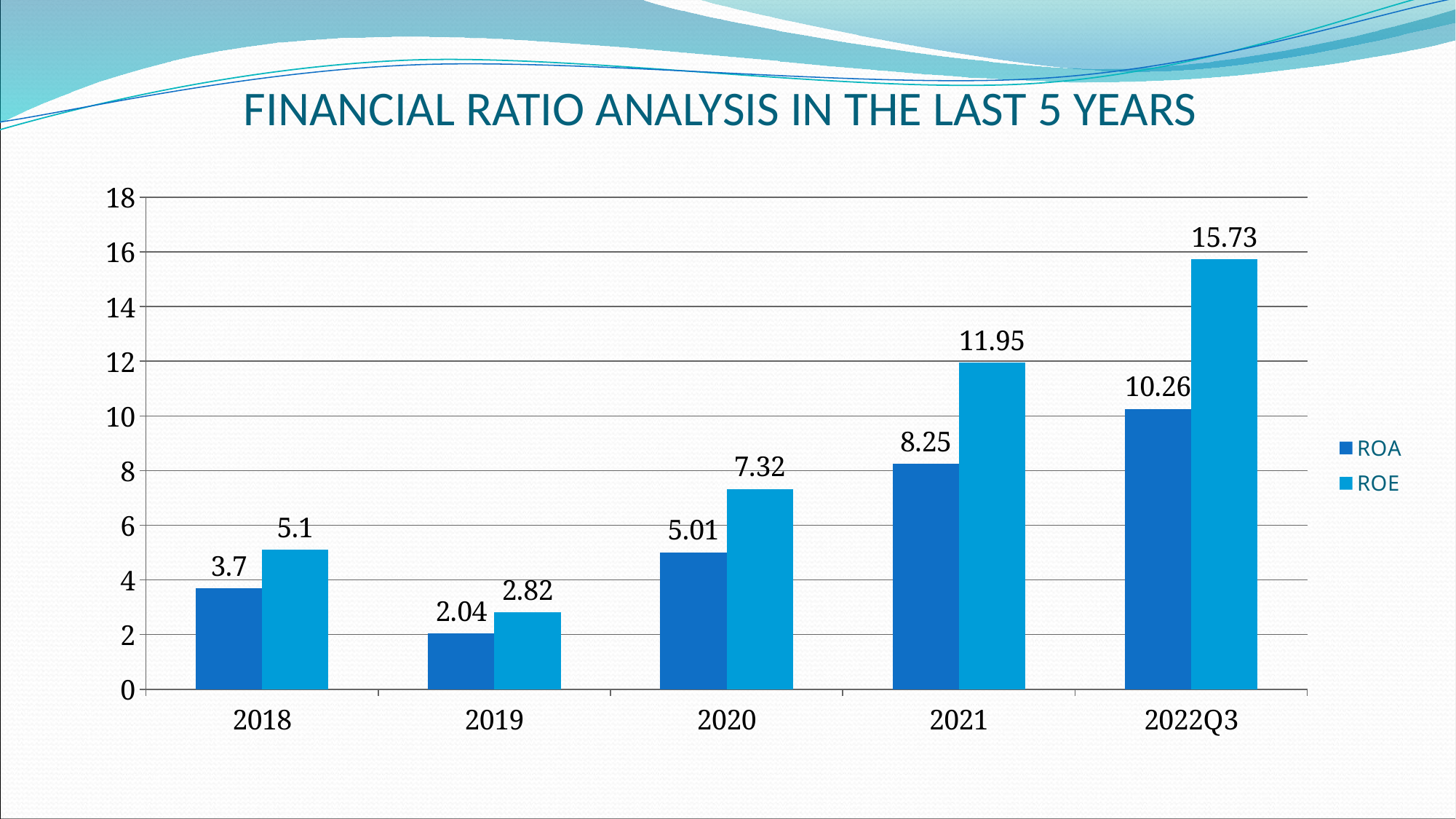
Which year has the highest ROE value? 2022Q3 Which year has the lowest ROA value? 2019 What is the difference between ROE and ROA in 2022Q3? 5.47 What is the title of the chart? FINANCIAL RATIO ANALYSIS IN THE LAST 5 YEARS Which is larger, the ROA value for 2018 or the ROA value for 2019? 2018 What is the ROE value for 2021? 11.95 What is the ROA value for 2020? 5.01 How many series does the legend list? 2 What is the difference between the ROE values for 2021 and 2020? 4.63 What is the ROA value for 2022Q3? 10.26 How many years (categories) are shown on the x axis? 5 What kind of chart is shown on the slide? Bar chart